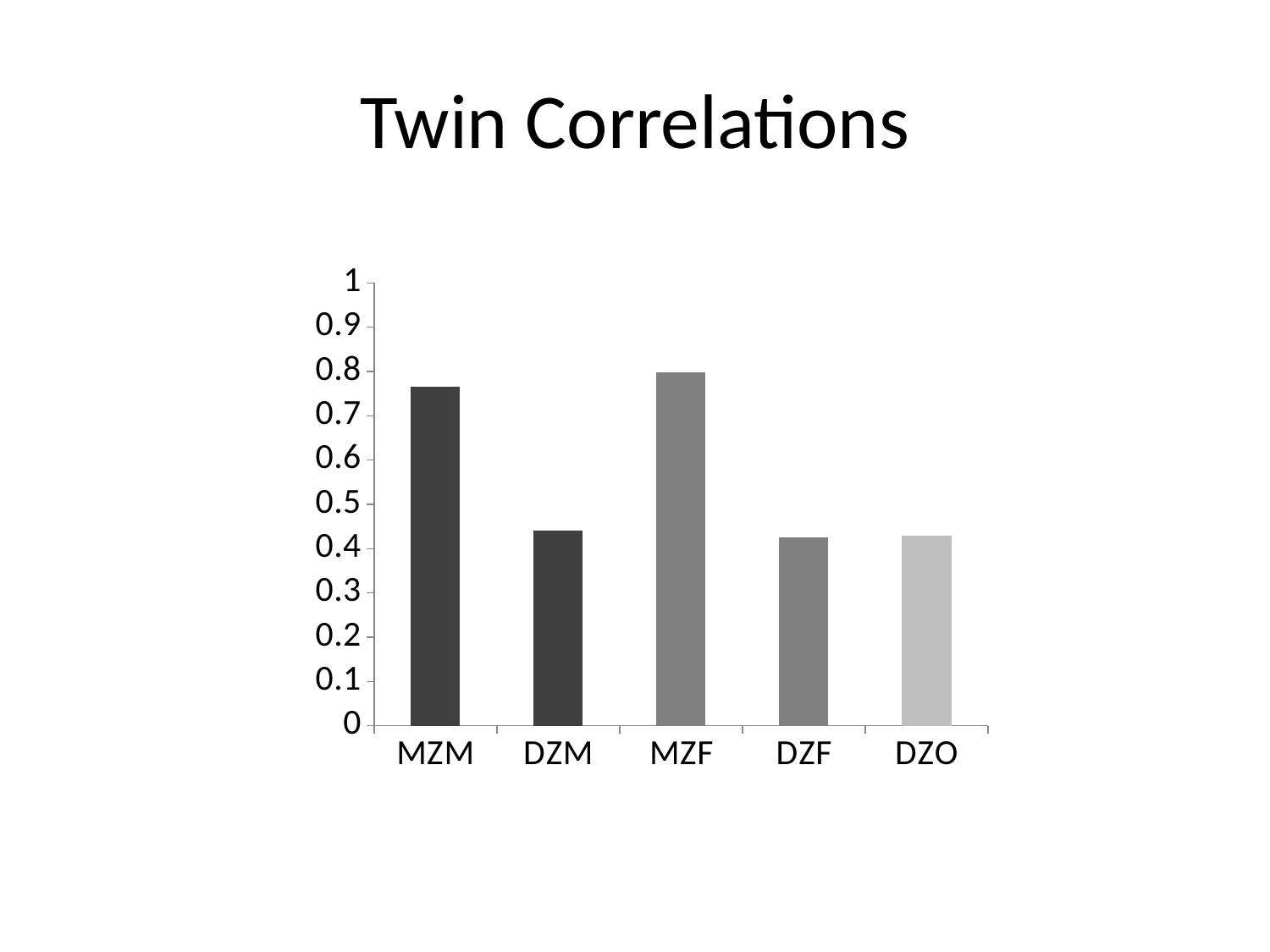
Is the value for MZM greater or less than 0.7? greater Which is larger, the value for MZM or the value for DZM? MZM Is the value for DZM greater or less than 0.4? greater Which category has the highest value? MZF Which is larger, the value for MZF or the value for DZF? MZF How many categories are shown on the x axis? 5 Is the value for DZM greater or less than 0.5? less What is the title of the chart? Twin Correlations What kind of chart is shown on the slide? bar chart